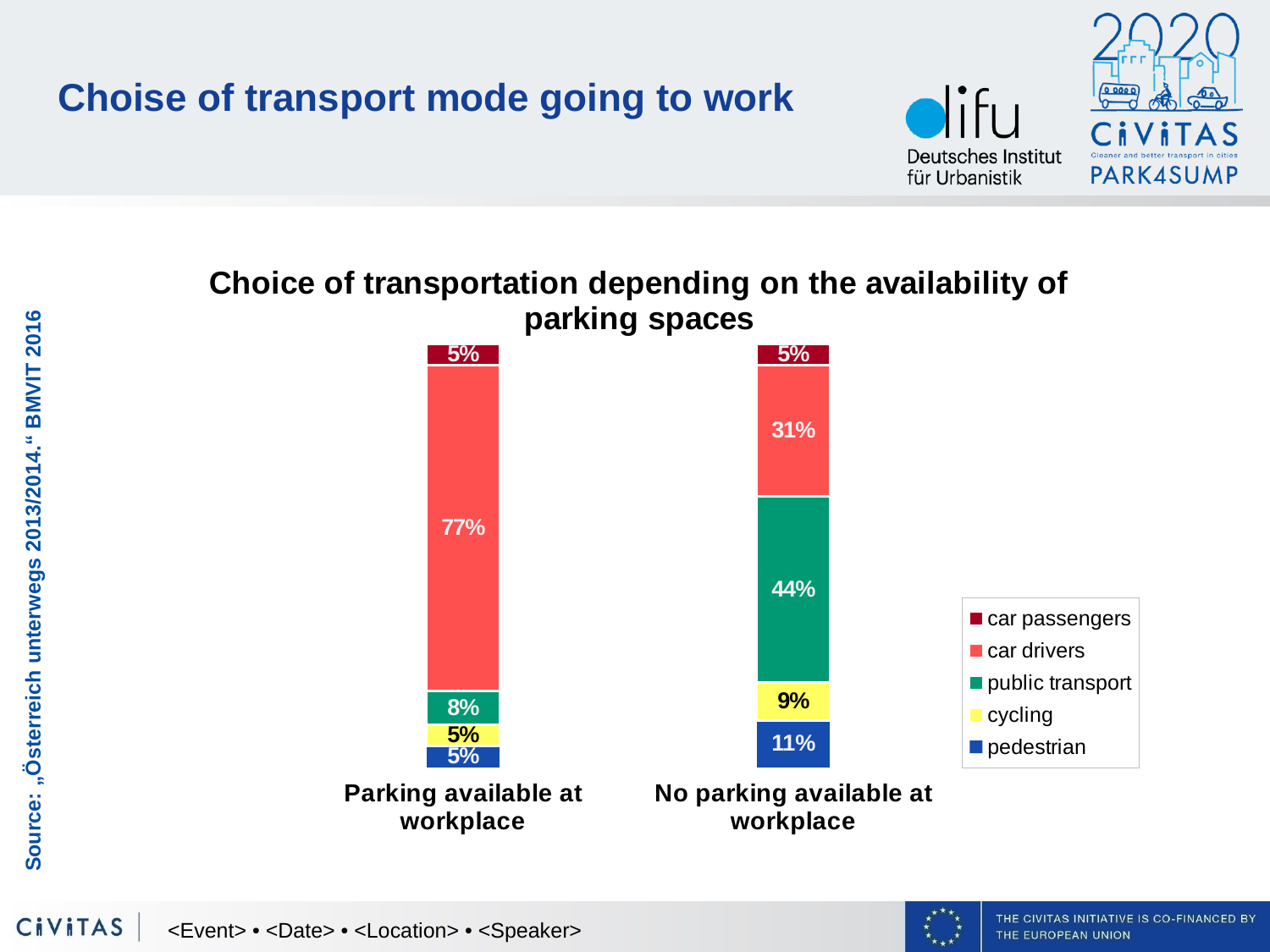
What share of car drivers is shown for "Parking available at workplace"? 77% How many series does the legend list? 5 What is the pedestrian share for "No parking available at workplace"? 11% What share of public transport is shown for "No parking available at workplace"? 44% What is the title of the chart? Choice of transportation depending on the availability of parking spaces Which transport mode has the largest share for "No parking available at workplace"? public transport Which transport mode has the largest share for "Parking available at workplace"? car drivers Which category has the larger public transport share: "Parking available at workplace" or "No parking available at workplace"? No parking available at workplace What is the cycling share for "Parking available at workplace"? 5% What is the difference in the car drivers share between "Parking available at workplace" and "No parking available at workplace"? 46% How many categories are shown on the x axis? 2 What kind of chart is shown on the slide? stacked bar chart